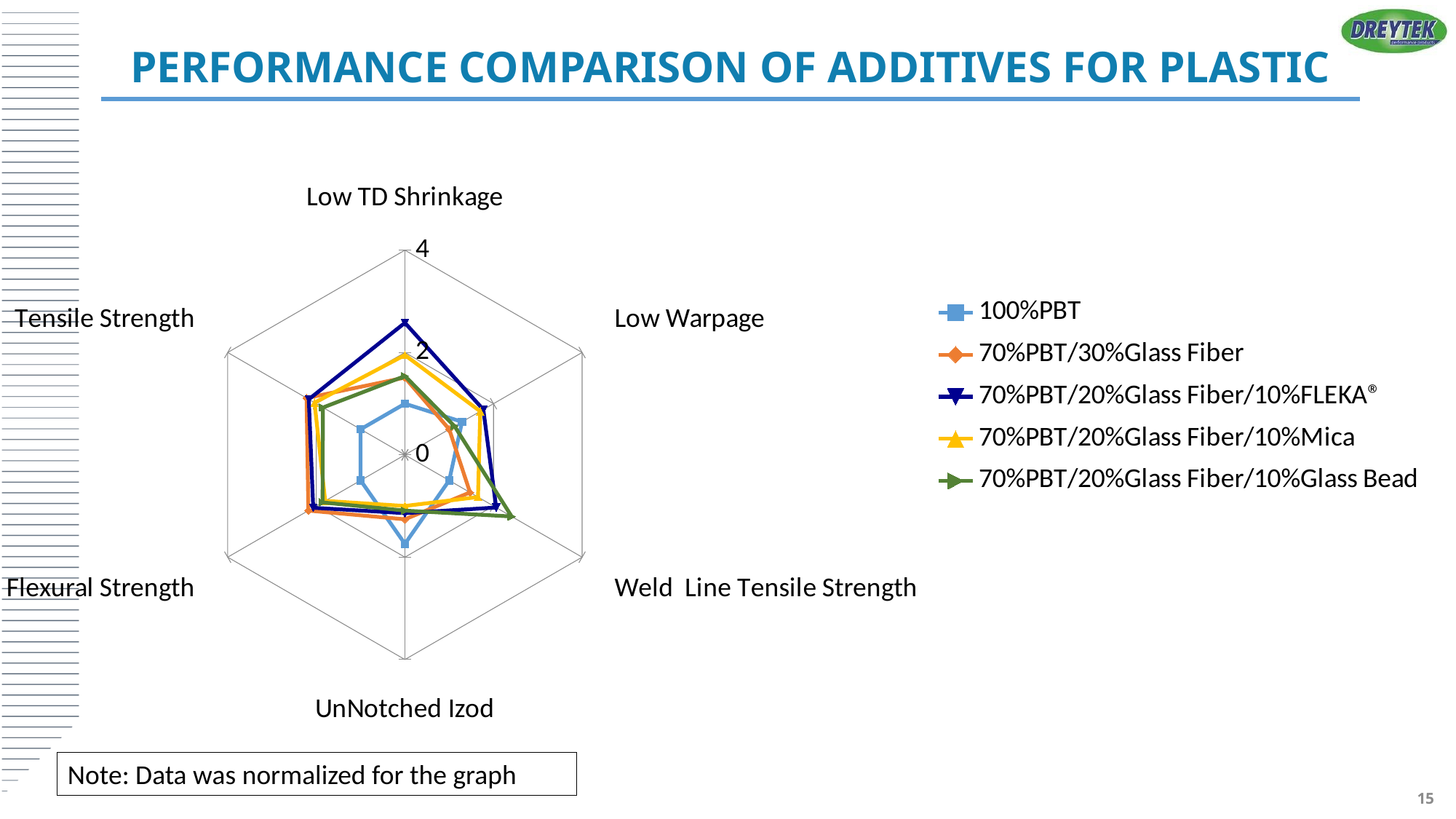
Which series has the highest value on the UnNotched Izod axis? 100%PBT How many axes (categories) does the radar chart have? 6 What is the title of the slide containing the chart? PERFORMANCE COMPARISON OF ADDITIVES FOR PLASTIC Is the value for 100%PBT on the Low TD Shrinkage axis greater or less than 2? less What is the maximum value shown on the radar chart's axis scale? 4 Is the value for 70%PBT/20%Glass Fiber/10%FLEKA on the Low TD Shrinkage axis greater or less than 2? greater What kind of chart is shown on the slide? Radar chart Which series has the lowest value on the Low TD Shrinkage axis? 100%PBT Which series has the highest value on the Weld Line Tensile Strength axis? 70%PBT/20%Glass Fiber/10%Glass Bead Which series has the highest value on the Low TD Shrinkage axis? 70%PBT/20%Glass Fiber/10%FLEKA How many series does the legend list? 5 On the Weld Line Tensile Strength axis, which is larger: 100%PBT or 70%PBT/20%Glass Fiber/10%Glass Bead? 70%PBT/20%Glass Fiber/10%Glass Bead